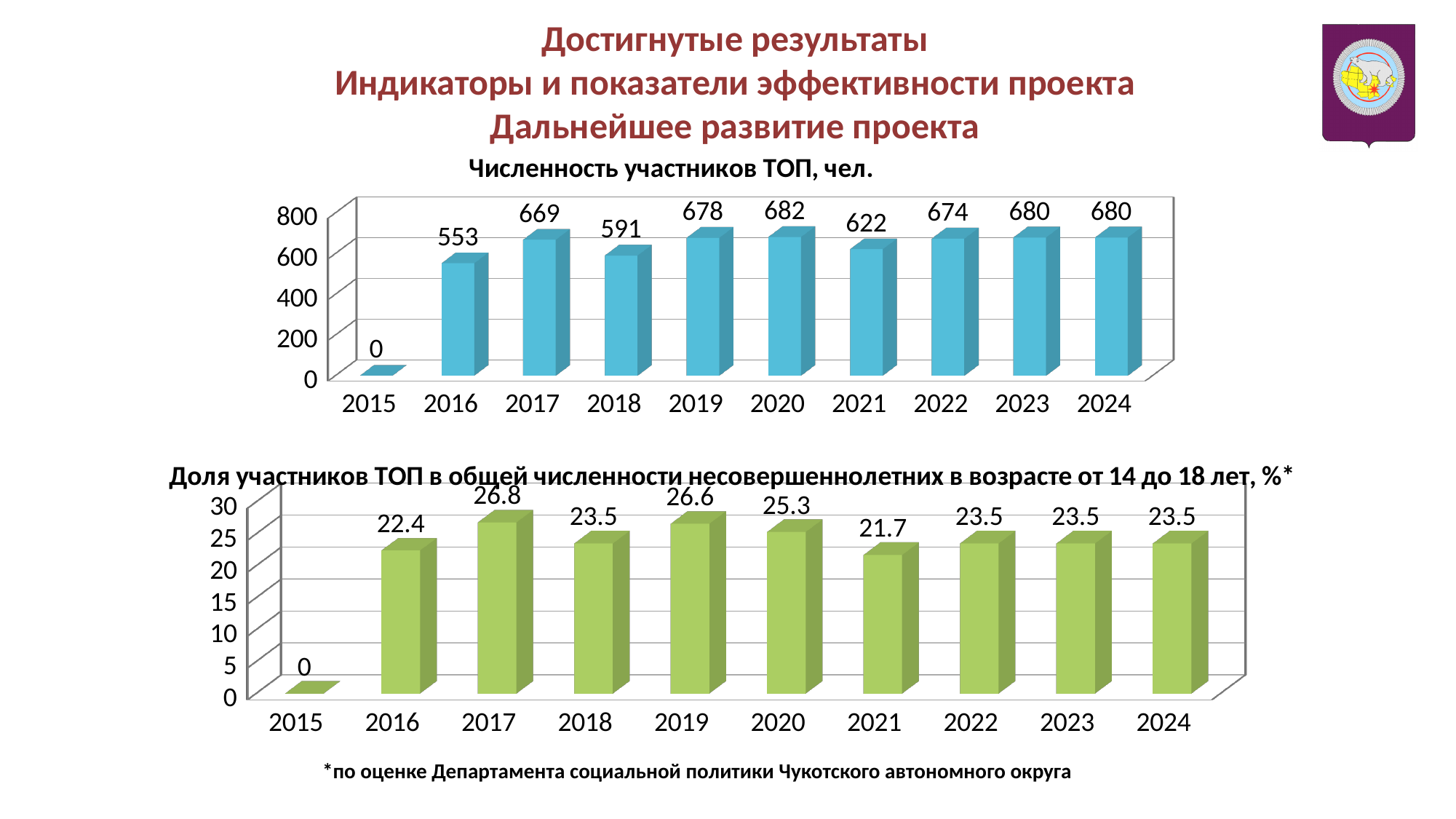
In the bottom chart 'Доля участников ТОП в общей численности несовершеннолетних в возрасте от 14 до 18 лет, %*', what is the difference between the values for 2017 and 2016? 4.4 In the top chart 'Численность участников ТОП, чел.', what is the difference between the values for 2017 and 2018? 78 In the bottom chart 'Доля участников ТОП в общей численности несовершеннолетних в возрасте от 14 до 18 лет, %*', which year from 2016 onwards has the lowest value? 2021 In the top chart 'Численность участников ТОП, чел.', what is the value for 2016? 553 In the top chart 'Численность участников ТОП, чел.', how many years are shown on the x axis? 10 In the bottom chart 'Доля участников ТОП в общей численности несовершеннолетних в возрасте от 14 до 18 лет, %*', what is the value for 2020? 25.3 What kind of chart is the top chart 'Численность участников ТОП, чел.'? bar chart In the bottom chart 'Доля участников ТОП в общей численности несовершеннолетних в возрасте от 14 до 18 лет, %*', is the value for 2019 greater or less than 25? greater What colour are the bars in the bottom chart 'Доля участников ТОП в общей численности несовершеннолетних в возрасте от 14 до 18 лет, %*'? green In the bottom chart 'Доля участников ТОП в общей численности несовершеннолетних в возрасте от 14 до 18 лет, %*', what is the value for 2015? 0 In the top chart 'Численность участников ТОП, чел.', which is larger, the value for 2019 or the value for 2021? 2019 In the top chart 'Численность участников ТОП, чел.', which year has the highest value? 2020